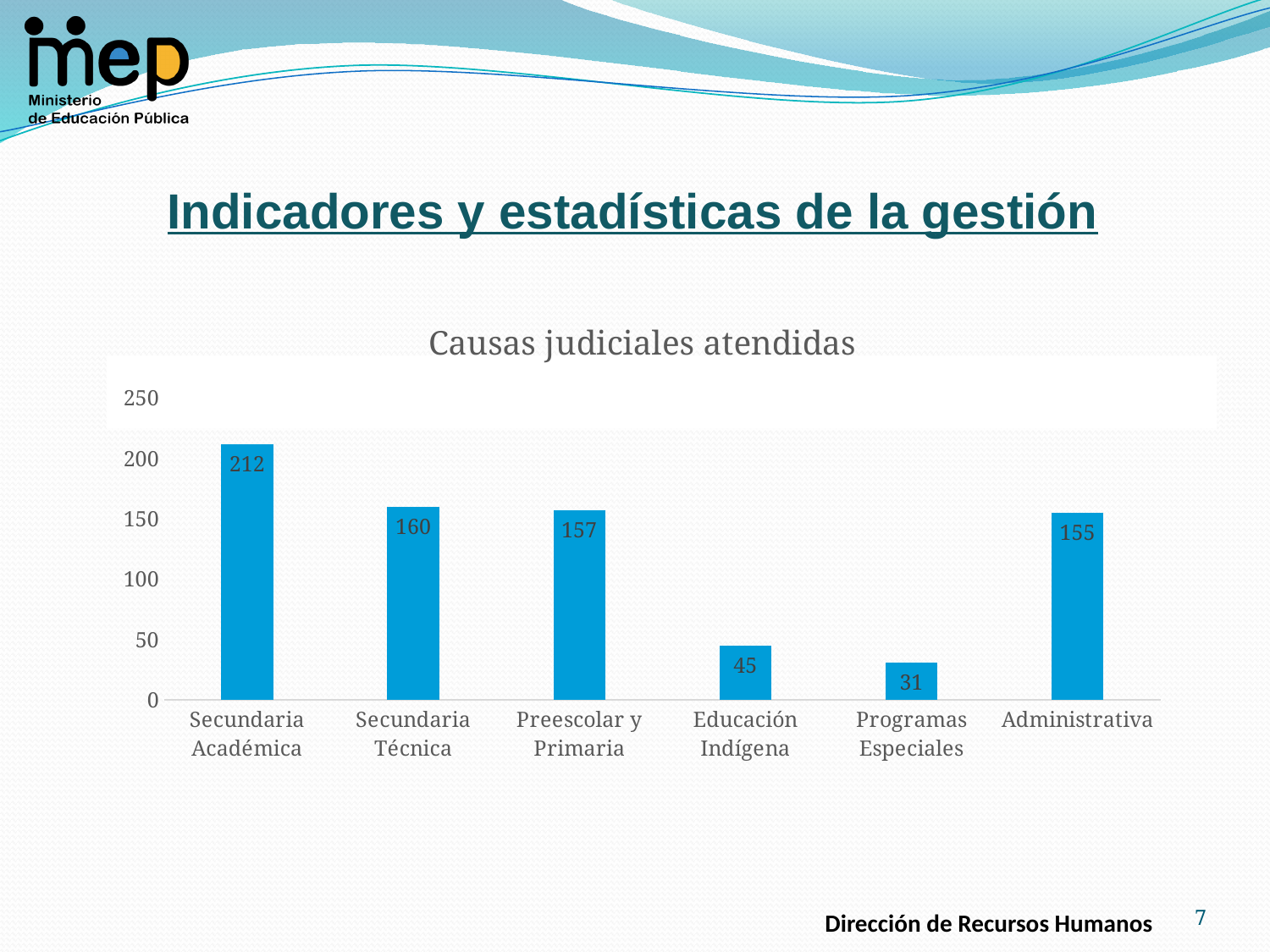
Which is larger, Secundaria Técnica or Administrativa? Secundaria Técnica Which category has the lowest value? Programas Especiales What is the value for Secundaria Académica? 212 What is the difference between Secundaria Académica and Secundaria Técnica? 52 What is the title of the chart? Causas judiciales atendidas What kind of chart is shown on the slide? bar chart What is the value for Educación Indígena? 45 Which category has the highest value? Secundaria Académica What is the difference between Educación Indígena and Programas Especiales? 14 How many categories are shown in the chart? 6 What is the value for Administrativa? 155 Is the value for Preescolar y Primaria greater or less than 100? greater